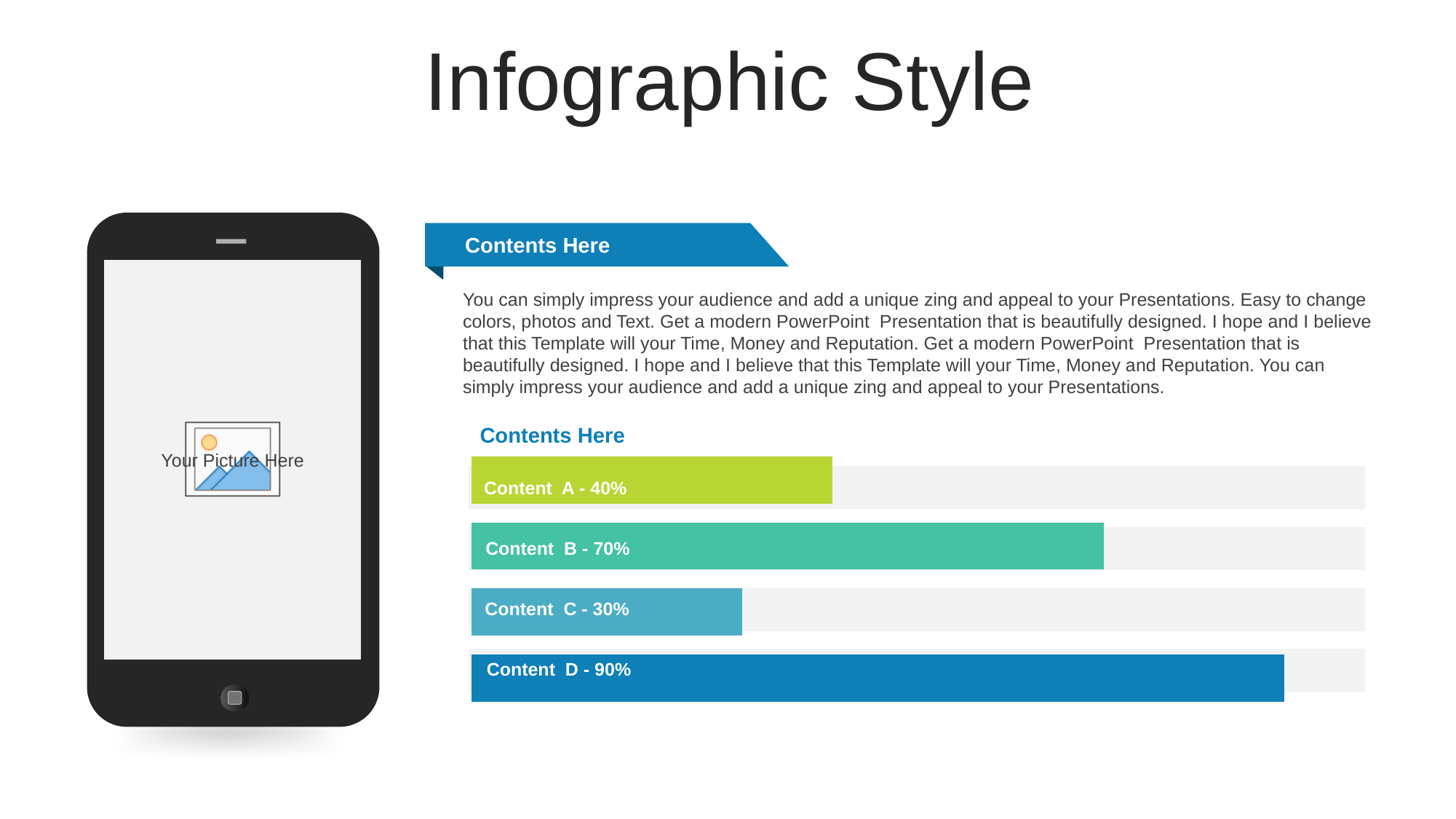
What is the difference between the values for Content B and Content C? 40% What is the value for Content B? 70% Which category has the highest value? Content D Which is larger, the value for Content B or the value for Content A? Content B What is the value for Content A? 40% Which category has the lowest value? Content C What is the value for Content D? 90% What kind of chart is shown on the slide? Bar chart How many categories are shown in the bar chart? 4 What colour is the bar for Content A? Green What is the value for Content C? 30% What is the difference between the values for Content D and Content A? 50%